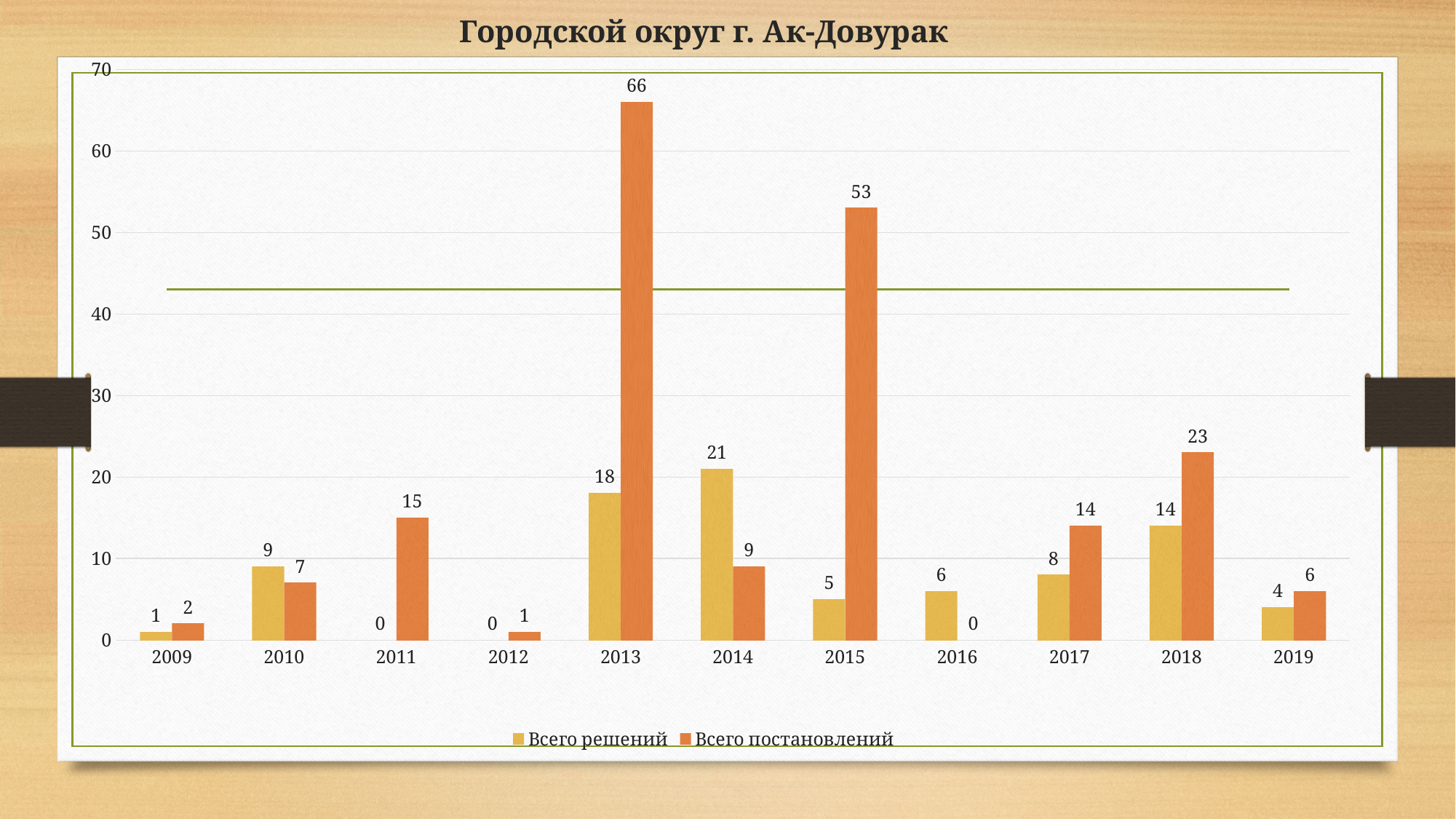
What is the title of the slide? Городской округ г. Ак-Довурак What is the difference between Всего постановлений and Всего решений in 2015? 48 Which year has the highest value for Всего постановлений? 2013 How many years are shown on the x axis? 11 Which is larger in 2014: Всего решений or Всего постановлений? Всего решений What kind of chart is shown on the slide? bar chart Which year has the highest value for Всего решений? 2014 What is the difference between Всего постановлений in 2018 and in 2019? 17 How many series does the legend list? 2 What is the value of Всего постановлений for 2013? 66 What is the value of Всего решений for 2014? 21 What is the value of Всего постановлений for 2011? 15